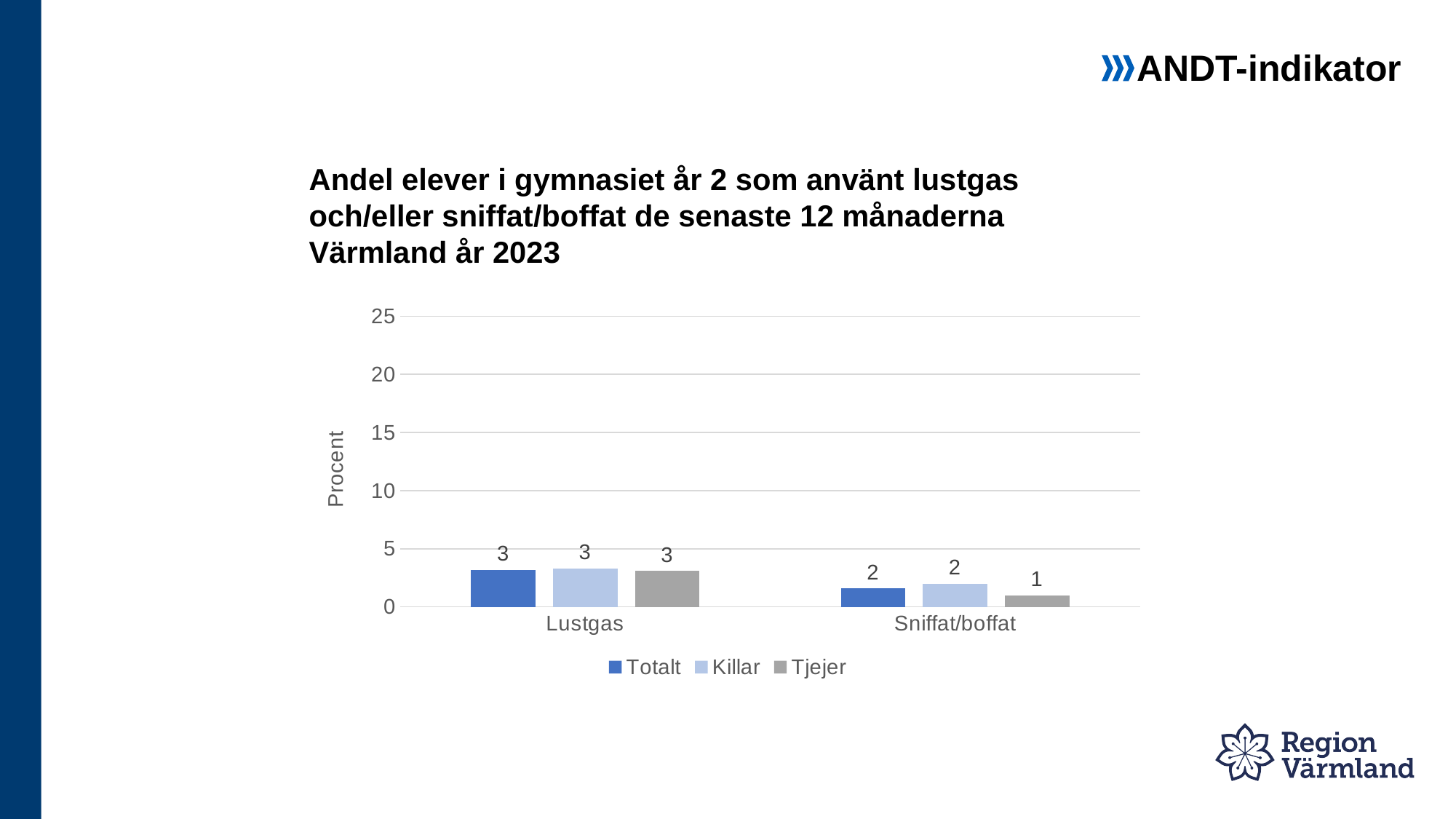
What kind of chart is shown on the slide? Bar chart Is the value for Killar in the Lustgas category greater or less than 5? less What is the value for Tjejer in the Sniffat/boffat category? 1 What is the value for Killar in the Sniffat/boffat category? 2 What is the label on the y axis? Procent Which is larger: the Totalt value for Lustgas or the Totalt value for Sniffat/boffat? Lustgas What is the difference between the Tjejer value for Lustgas and the Tjejer value for Sniffat/boffat? 2 Do the Totalt values rise or fall from Lustgas to Sniffat/boffat? fall Which series has the lowest value in the Sniffat/boffat category? Tjejer How many series does the legend list? 3 What is the value for Totalt in the Lustgas category? 3 How many categories are shown on the x axis? 2